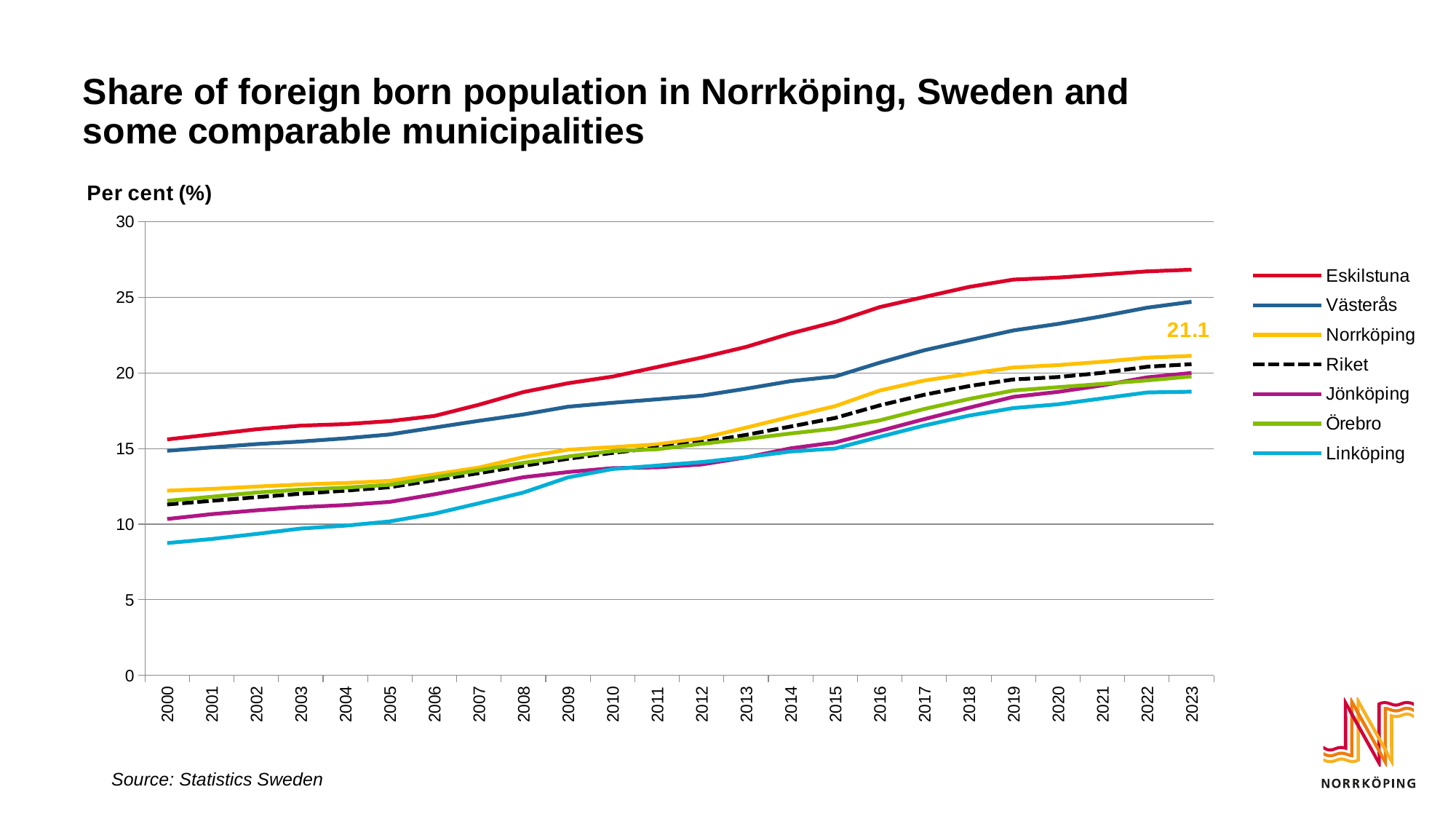
What is the value for Norrköping in 2023? 21.1 Does the value for Eskilstuna rise or fall from 2000 to 2023? rise What kind of chart is shown on the slide? line chart How many series does the legend list? 7 Which series has the lowest value in 2000? Linköping Which is larger in 2023, the value for Västerås or the value for Jönköping? Västerås How many years are shown on the x axis? 24 Is the value for Linköping in 2000 greater or less than 10? less Which series is drawn as a dashed line? Riket Which series has the highest value in 2023? Eskilstuna Is the value for Eskilstuna in 2023 greater or less than 25? greater Is the value for Västerås in 2010 greater or less than 20? less